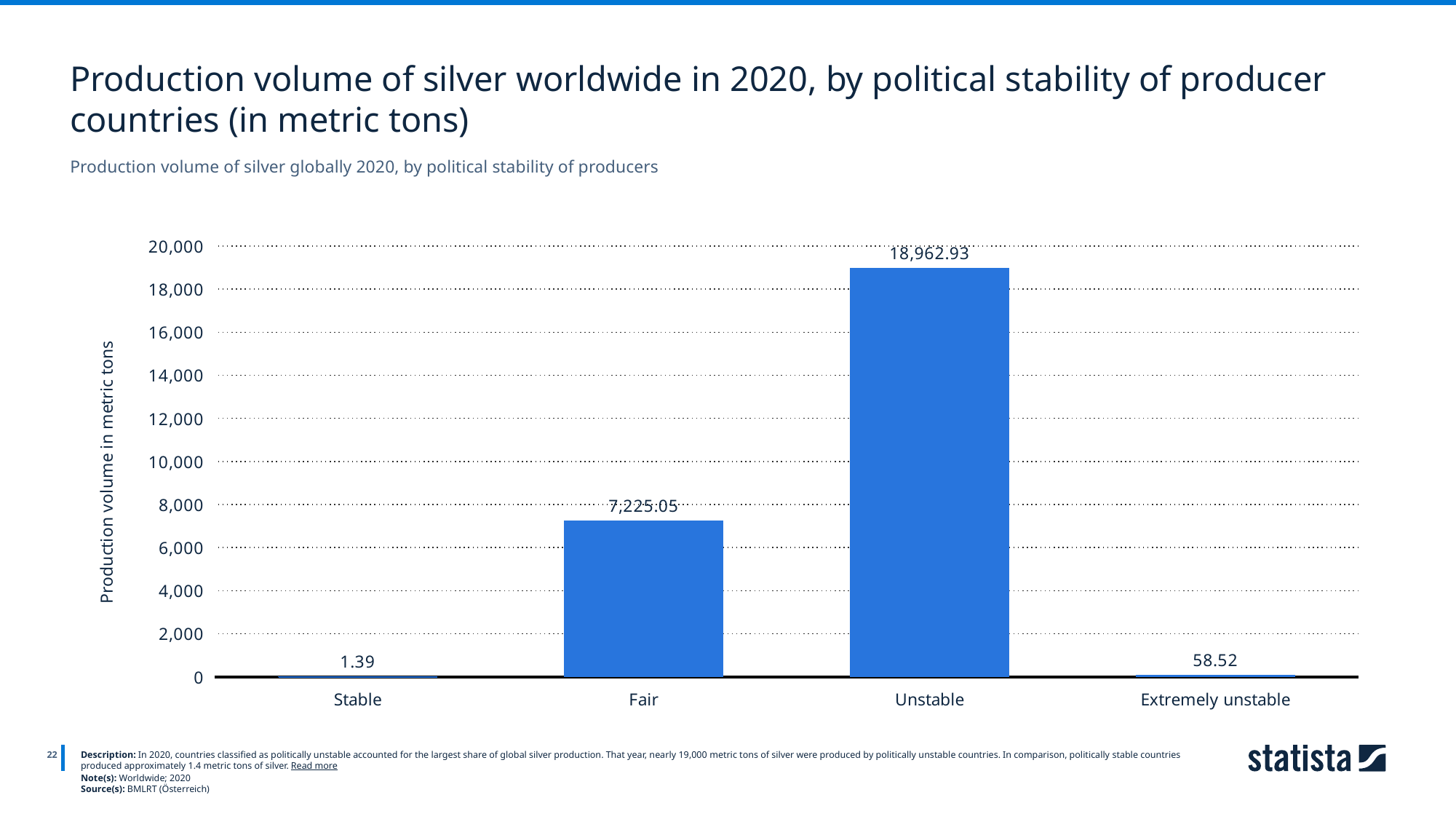
What is the production volume of silver for Fair producer countries? 7,225.05 How many political stability categories are shown on the chart? 4 Which has a larger production volume, Extremely unstable or Stable? Extremely unstable What is the production volume of silver for Unstable producer countries? 18,962.93 Is the production volume for Fair producer countries greater or less than 8,000? less What is the label of the vertical axis? Production volume in metric tons Which political stability category has the lowest silver production volume? Stable What kind of chart is shown on the slide? bar chart What is the production volume of silver for Extremely unstable producer countries? 58.52 Which political stability category has the highest silver production volume? Unstable What is the production volume of silver for Stable producer countries? 1.39 What is the difference in production volume between Unstable and Fair producer countries? 11,737.88